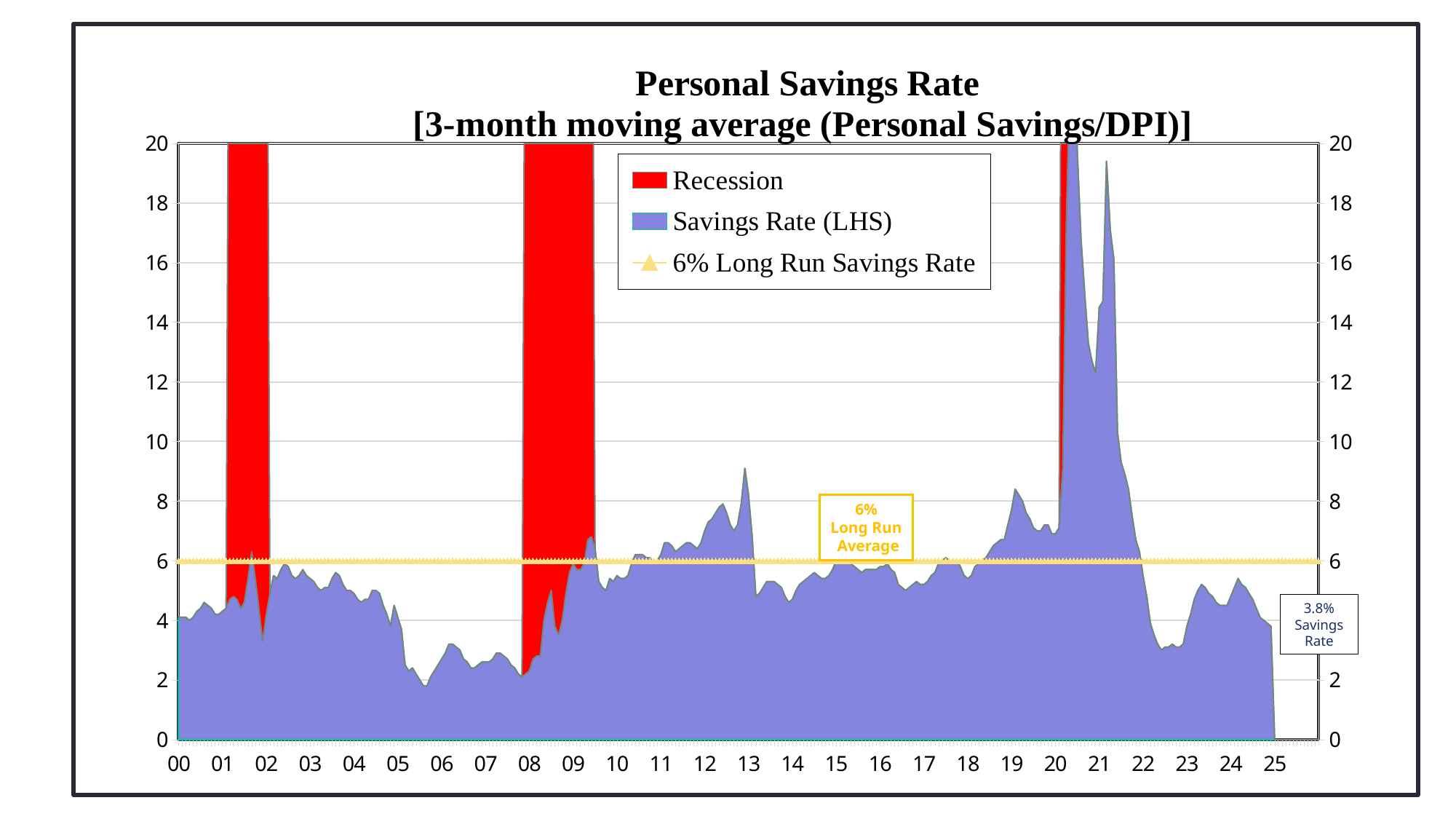
What kind of chart is this? area chart What is the title of the chart? Personal Savings Rate [3-month moving average (Personal Savings/DPI)] Is the savings rate in 2006 greater or less than 4? less How many series does the legend list? 3 In which year on the x axis does the savings rate reach its highest value? 20 Is the savings rate higher in 2012 or in 2006? 2012 Is the savings rate peak in 2021 greater or less than 18? greater What is the long run savings rate shown by the horizontal line? 6% What is the most recent savings rate value labelled on the chart? 3.8% How many recession periods are shaded on the chart? 3 Does the savings rate rise or fall between 21 and 22 on the x axis? fall Which colour is used for the Recession series in the legend? red